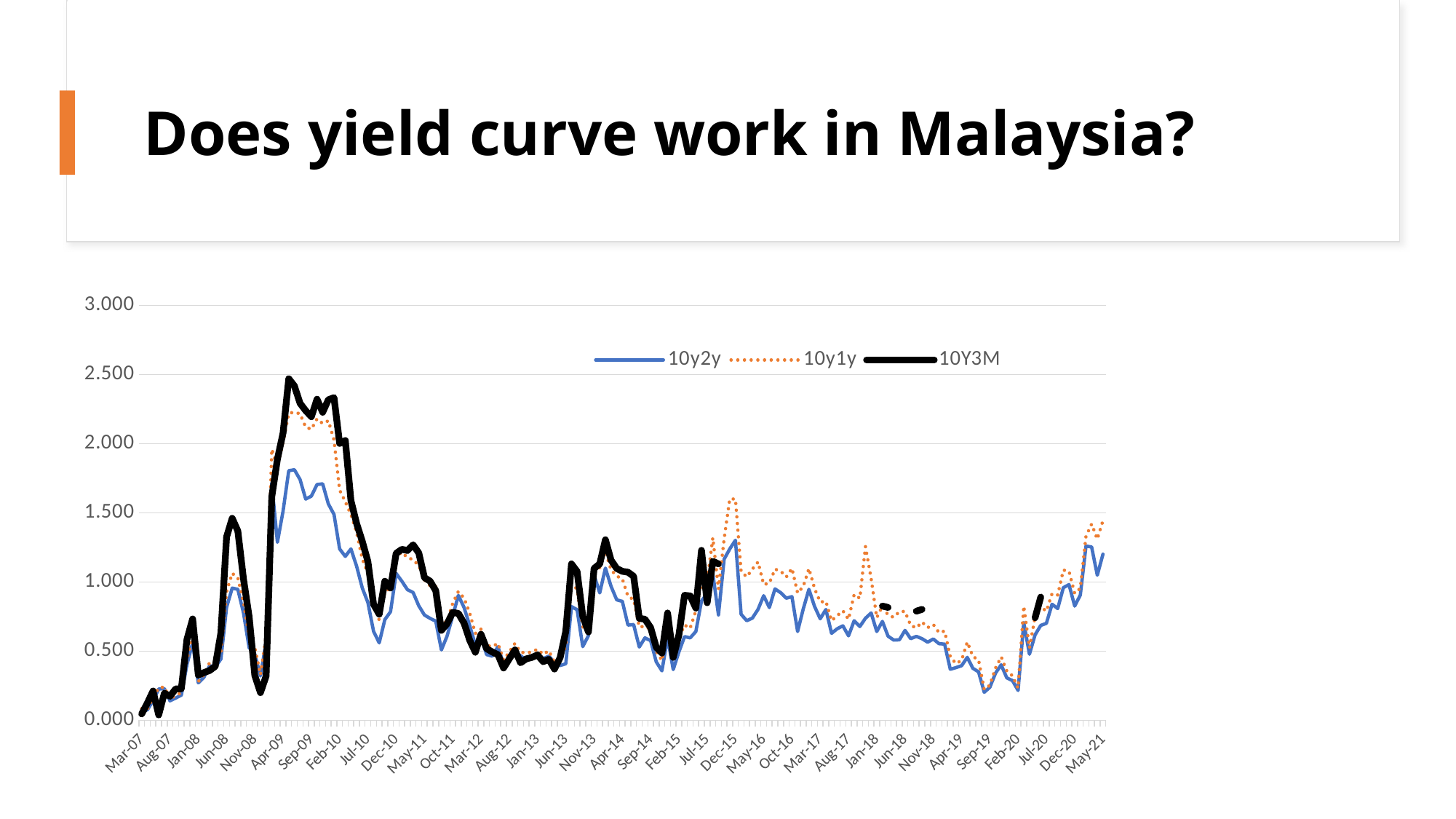
Is the highest value of the 10y1y series greater or less than 1.500? greater What are the three series named in the legend? 10y2y, 10y1y, 10Y3M Is the value of the 10y2y series at Mar-07 greater or less than 0.500? less What kind of chart is shown on the slide? line chart From Sep-19 to May-21, does the 10y2y series rise or fall? rise What is the highest value shown on the y axis? 3.000 Which series reaches the highest value on the chart? 10Y3M Is the highest value of the 10y2y series greater or less than 2.000? less From Apr-09 to Jul-10, does the 10Y3M series rise or fall? fall How many series does the legend list? 3 Around the Apr-09 peak, which series is higher, 10Y3M or 10y2y? 10Y3M